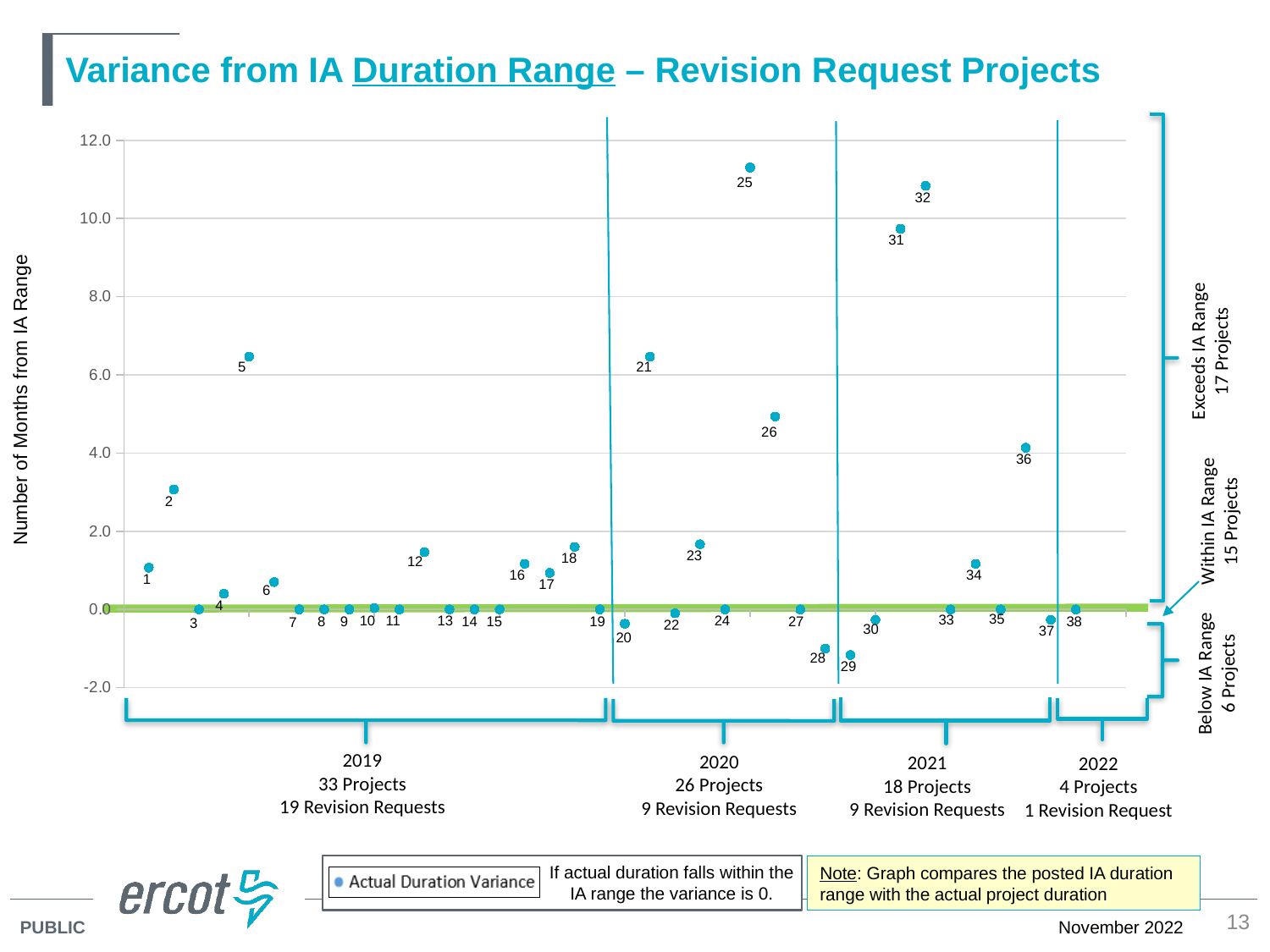
What is the name of the series shown in the legend? Actual Duration Variance Is the value for point 2 greater or less than 2.0? greater Which has the larger value, point 5 or point 2? 5 Which numbered point has the lowest value on the chart? 29 Is the value for point 26 greater or less than 6.0? less What is the title of the vertical axis? Number of Months from IA Range How many data points are plotted on the chart? 38 Which has the larger value, point 25 or point 32? 25 What kind of chart is shown on the slide? Scatter chart Which numbered point has the highest value on the chart? 25 Is the value for point 5 greater or less than 6.0? greater How many series does the legend list? 1